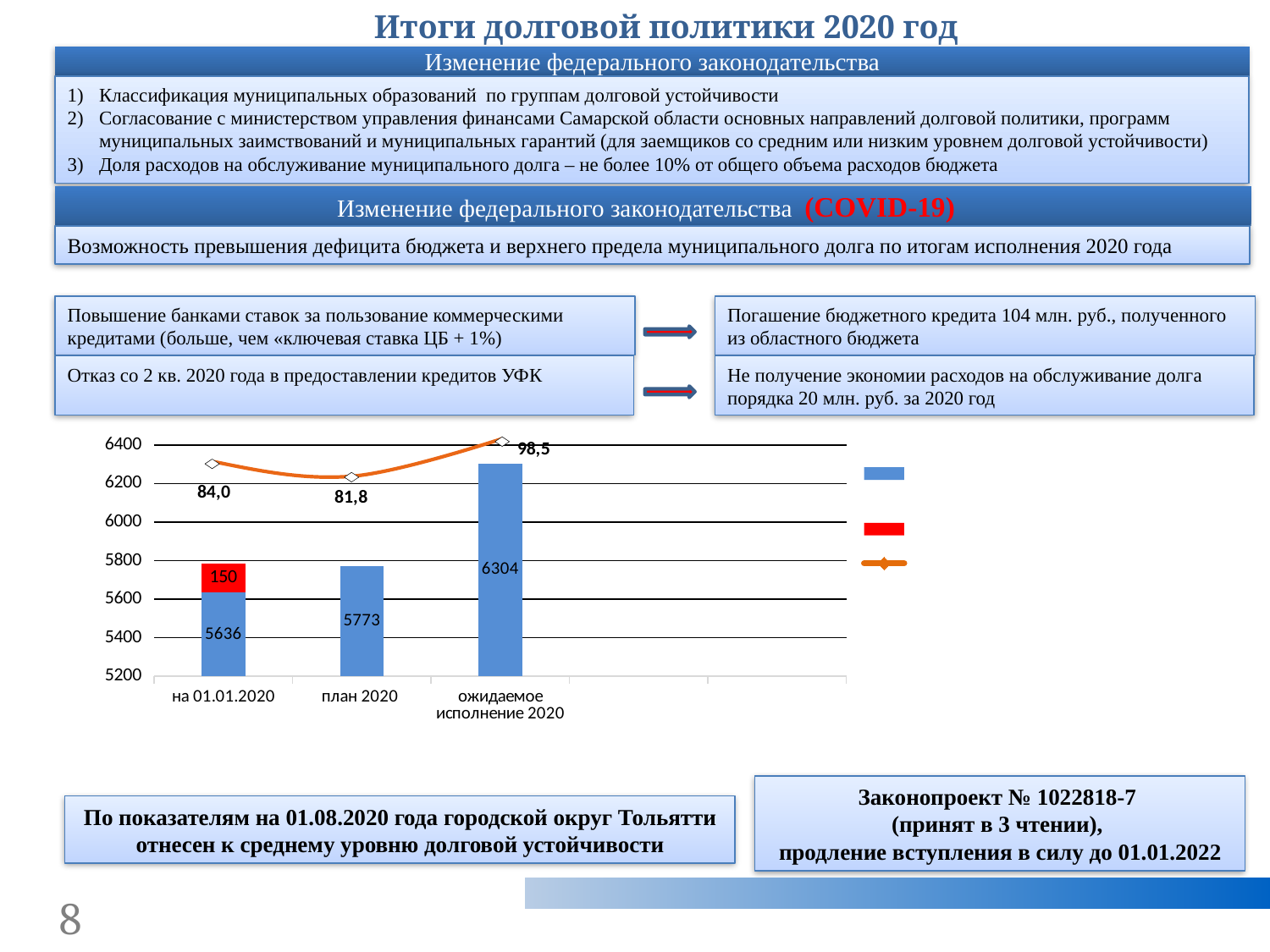
Which category has the highest blue bar? ожидаемое исполнение 2020 What is the value of the blue bar for 'ожидаемое исполнение 2020'? 6304 What is the value of the red segment on the 'на 01.01.2020' bar? 150 What is the value of the blue bar for 'план 2020'? 5773 What value does the line show for 'план 2020'? 81,8 How many categories are shown on the x axis of the chart? 3 Is the blue bar for 'план 2020' greater or less than 6000? less What is the difference between the blue bars for 'ожидаемое исполнение 2020' and 'план 2020'? 531 What is the total height of the stacked bar for 'на 01.01.2020' (blue plus red)? 5786 Do the blue bars rise or fall from left to right across the categories? rise Which category has the lowest value on the line? план 2020 Which is larger: the blue bar for 'план 2020' or the blue bar for 'на 01.01.2020'? план 2020